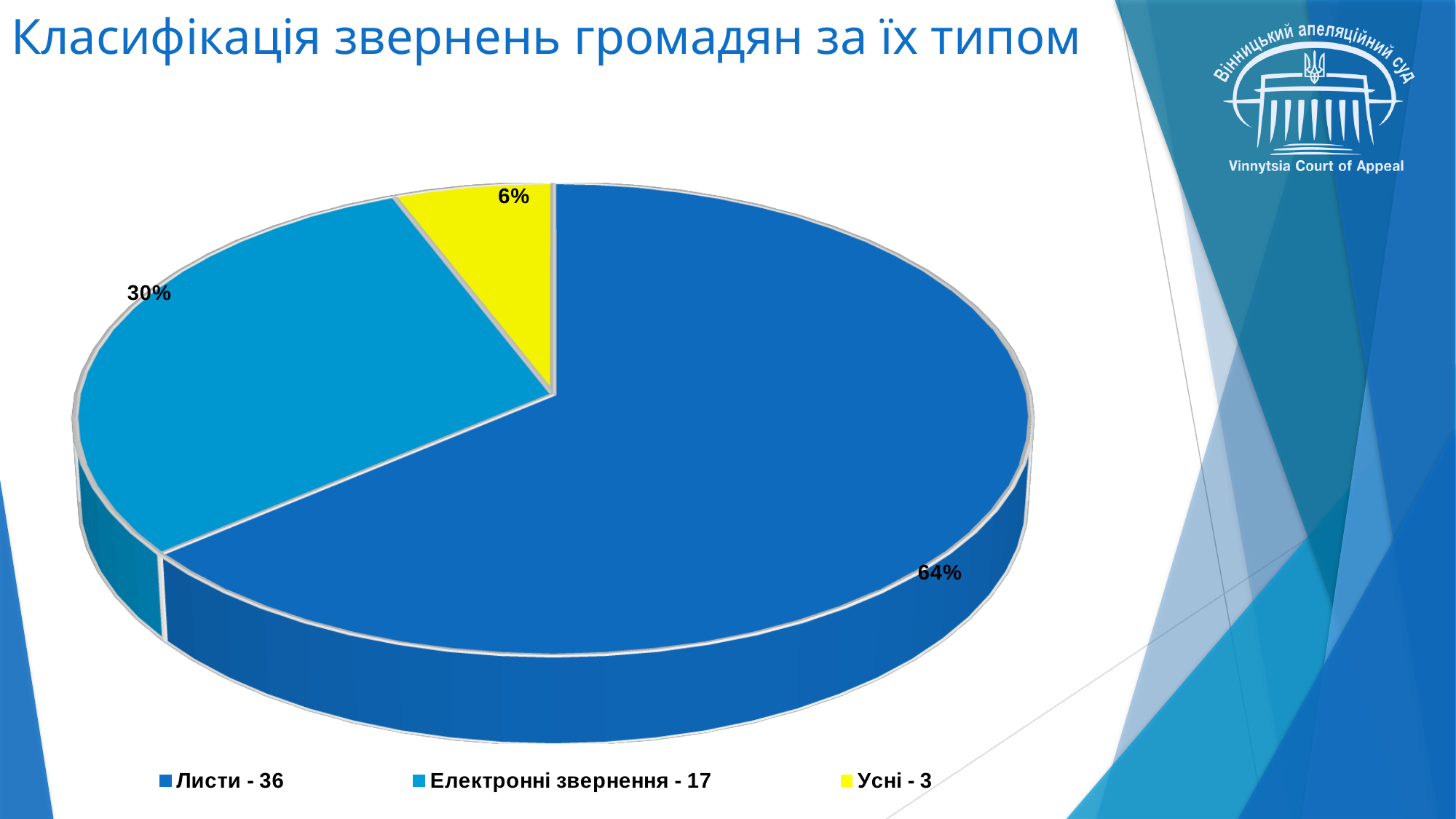
What kind of chart is shown on the slide? pie chart What is the difference in percentage points between the "Листи - 36" slice and the "Електронні звернення - 17" slice? 34 How many slices does the pie chart have? 3 Which category has the smallest slice of the pie? Усні - 3 What percentage share does the "Усні - 3" slice have? 6% What colour is the "Усні - 3" slice? yellow How many entries does the legend list? 3 Which slice is larger: "Електронні звернення - 17" or "Усні - 3"? Електронні звернення - 17 Which category has the largest slice of the pie? Листи - 36 What is the title of the chart on the slide? Класифікація звернень громадян за їх типом What percentage share does the "Листи - 36" slice have? 64% What percentage share does the "Електронні звернення - 17" slice have? 30%